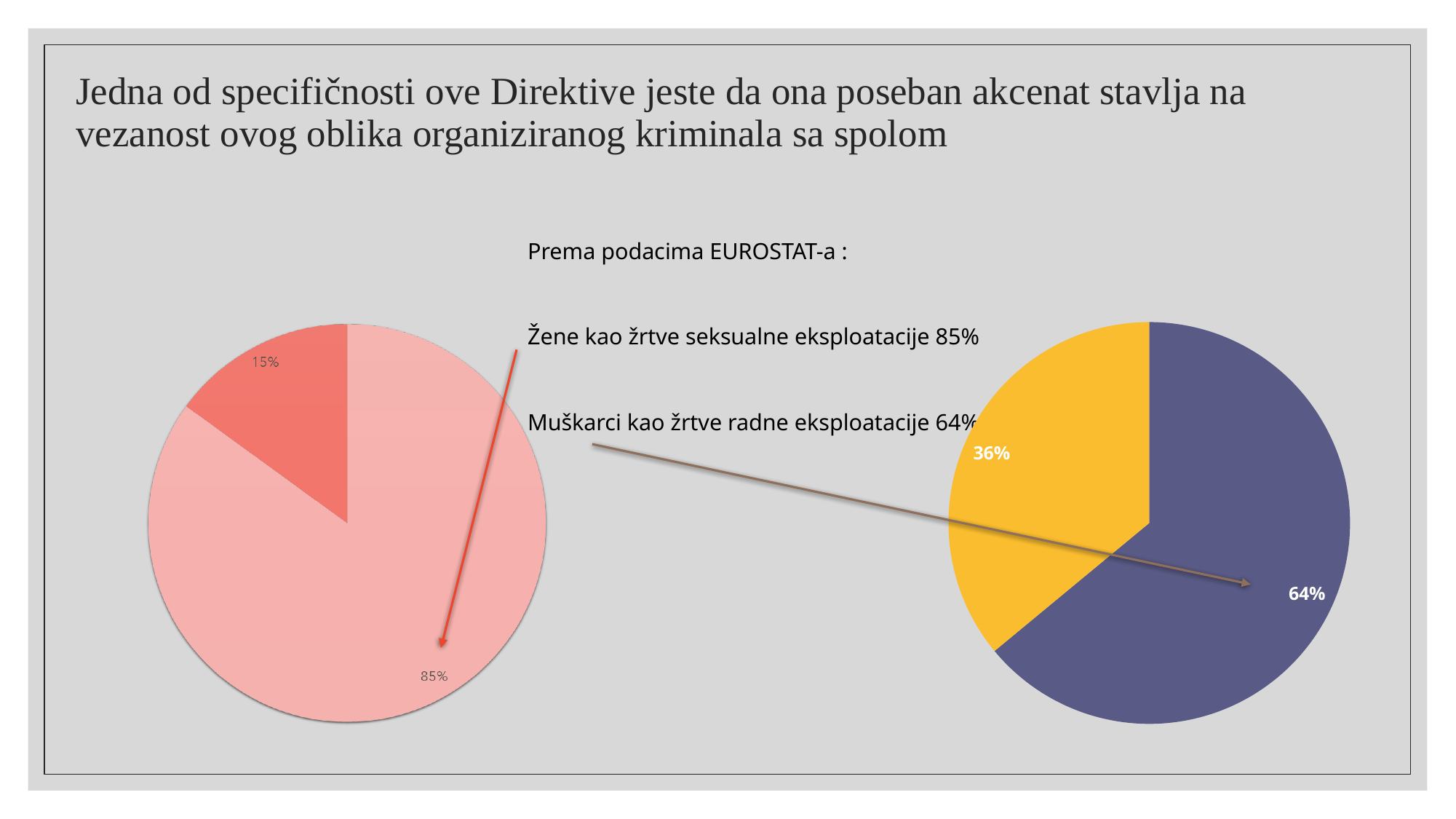
How many slices does the left pie chart have? 2 In the left pie chart, what is the difference between the two slice values? 70% In the right pie chart, what value is shown on the dark blue slice? 64% In the right pie chart, which slice is larger, the yellow one or the dark blue one? the dark blue one What kind of chart is the chart on the right of the slide? pie chart In the right pie chart, what value is shown on the yellow slice? 36% In the left pie chart, what value is shown on the larger, light pink slice? 85% In the right pie chart, what is the difference between the two slice values? 28% What kind of chart is the chart on the left of the slide? pie chart According to the slide text, which pie chart slice does the arrow from 'Žene kao žrtve seksualne eksploatacije 85%' point to? the 85% slice of the left pie chart How many slices does the right pie chart have? 2 In the left pie chart, what value is shown on the smaller, darker red slice? 15%